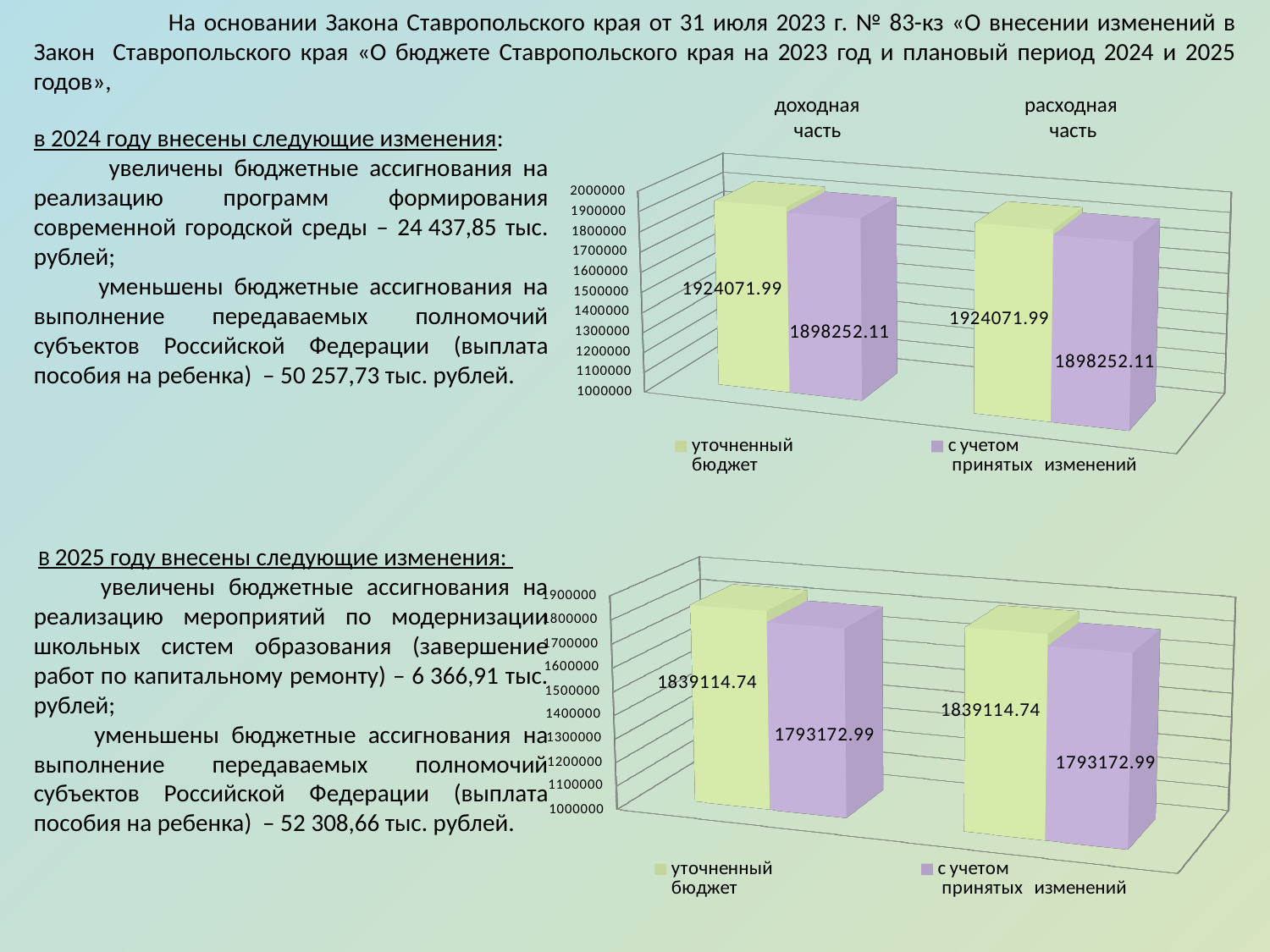
In the bottom chart, what is the value of the 'с учетом принятых изменений' bar in the right group? 1793172.99 In the bottom chart, is the value of the 'с учетом принятых изменений' bar greater or less than 1800000? less In the bottom chart, what is the difference between the 'уточненный бюджет' and 'с учетом принятых изменений' values in the left group? 45941.75 In the top chart, what is the value of the 'с учетом принятых изменений' bar for 'расходная часть'? 1898252.11 In the top chart, what is the value of the 'уточненный бюджет' bar for 'доходная часть'? 1924071.99 In the bottom chart, what is the value of the 'уточненный бюджет' bar in the left group? 1839114.74 In the top chart, what is the difference between the 'уточненный бюджет' and 'с учетом принятых изменений' values for 'расходная часть'? 25819.88 In the top chart, what colour are the 'с учетом принятых изменений' bars? purple What type of chart is the top chart? bar chart How many series does the legend of the top chart list? 2 In the top chart, which series has the larger value for 'доходная часть': 'уточненный бюджет' or 'с учетом принятых изменений'? уточненный бюджет How many category groups of bars are shown in the bottom chart? 2